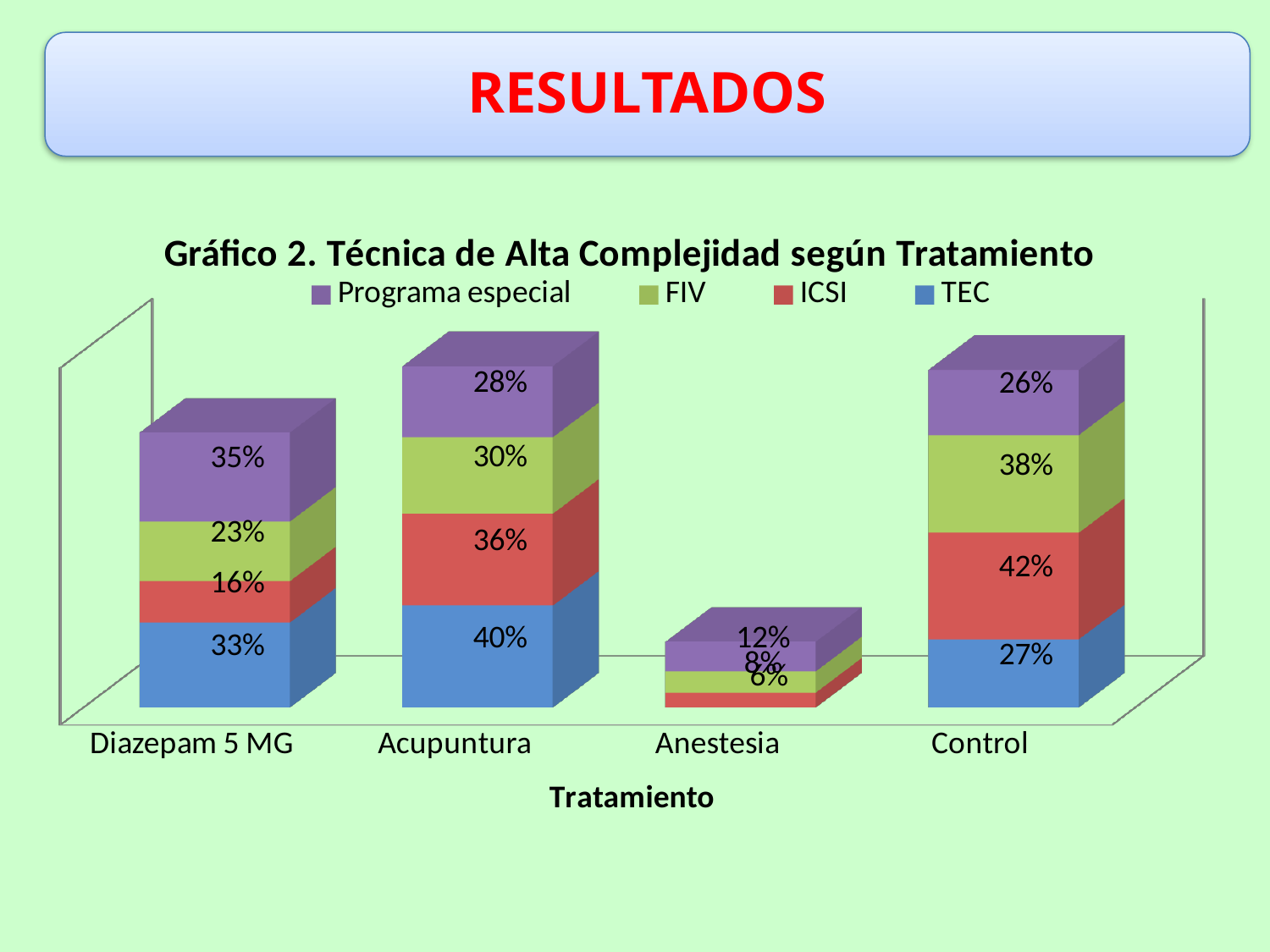
What is the difference between the ICSI value for Acupuntura and the ICSI value for Diazepam 5 MG? 20 percentage points What is the ICSI value for Control? 42% How many series does the legend list? 4 Which treatment has the smallest stacked bar overall? Anestesia Which is larger, the FIV value for Control or the FIV value for Acupuntura? Control What is the FIV value for Control? 38% What is the title of the chart? Gráfico 2. Técnica de Alta Complejidad según Tratamiento Which treatment has the highest TEC value? Acupuntura What is the Programa especial value for Diazepam 5 MG? 35% What kind of chart is shown on the slide? Stacked bar chart How many treatment categories are shown on the x axis? 4 What is the TEC value for Acupuntura? 40%